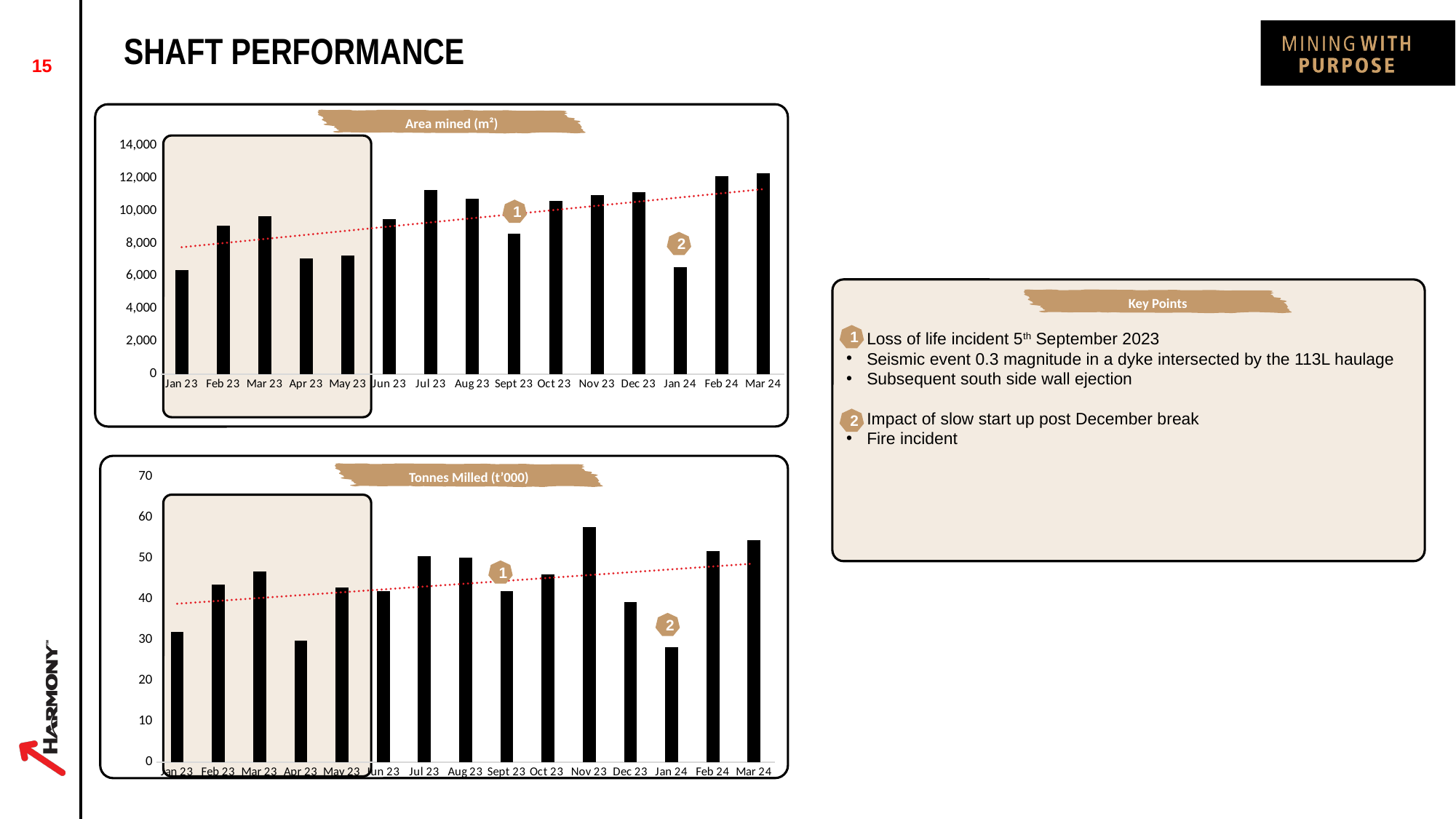
How many months are shown on the x axis of the 'Tonnes Milled (t'000)' chart? 15 What type of chart is the 'Area mined (m²)' chart? bar chart What is the title of the lower chart on the slide? Tonnes Milled (t'000) In the 'Tonnes Milled (t'000)' chart, is the value for Nov 23 greater or less than 50? greater In the 'Tonnes Milled (t'000)' chart, is the value for Jan 24 greater or less than 30? less In the 'Area mined (m²)' chart, is the value for Jul 23 greater or less than 10,000? greater In the 'Tonnes Milled (t'000)' chart, which month has the highest value? Nov 23 In the 'Tonnes Milled (t'000)' chart, which is larger, Nov 23 or Dec 23? Nov 23 In the 'Area mined (m²)' chart, which is larger, Mar 23 or Apr 23? Mar 23 In the 'Area mined (m²)' chart, does the dotted trend line rise or fall from Jan 23 to Mar 24? rise